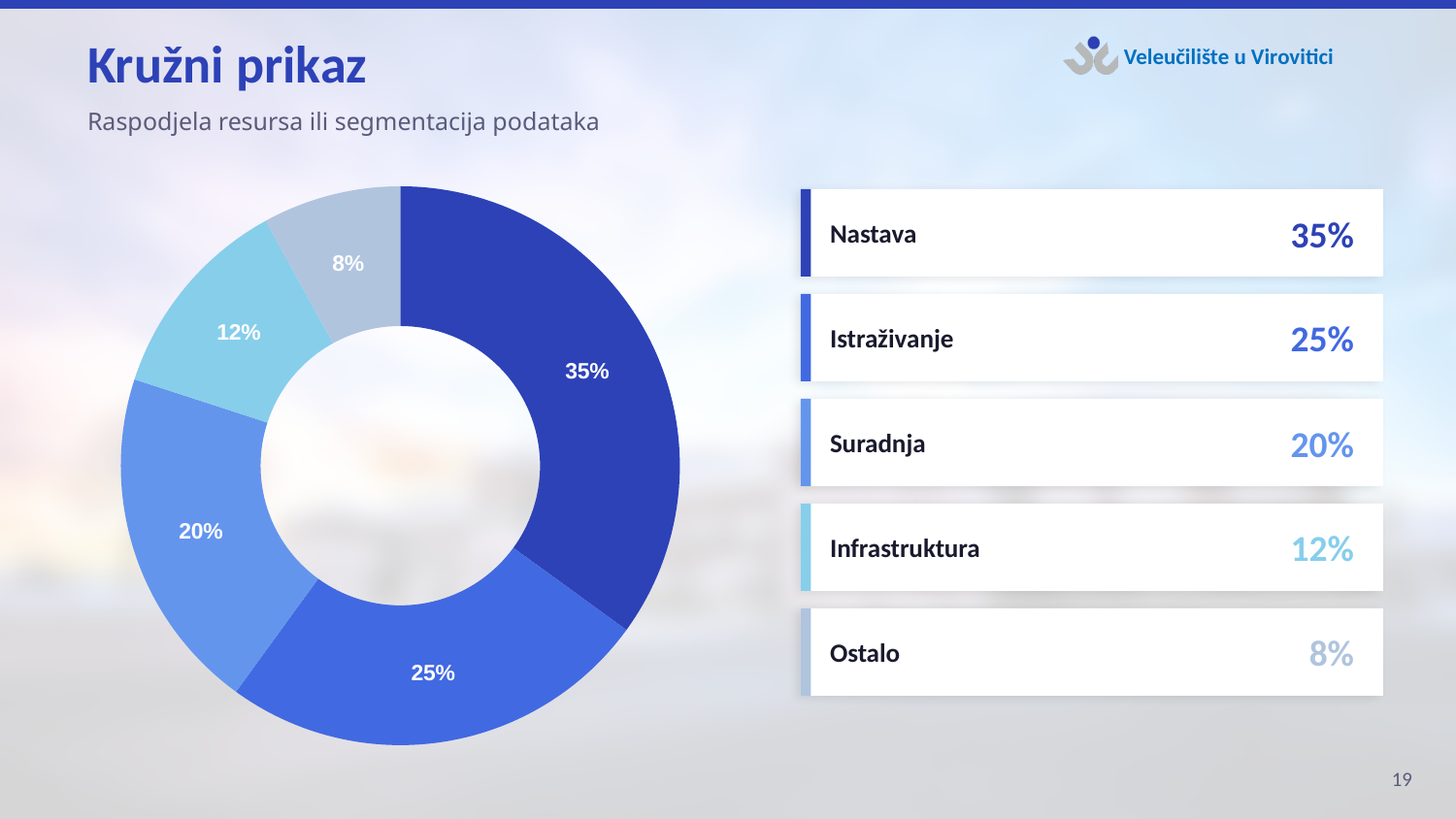
What is the value for Infrastruktura? 12% What is the title of the slide containing the chart? Kružni prikaz What kind of chart is shown on the slide? Donut (pie) chart What is the value for Suradnja? 20% Which category has the largest share of the chart? Nastava Which category has the smallest share of the chart? Ostalo What share of the chart does Nastava have? 35% Which is larger, the share for Suradnja or the share for Infrastruktura? Suradnja What is the value for Ostalo? 8% What is the value for Istraživanje? 25% How many slices does the chart have? 5 What is the difference between the shares of Nastava and Istraživanje? 10%